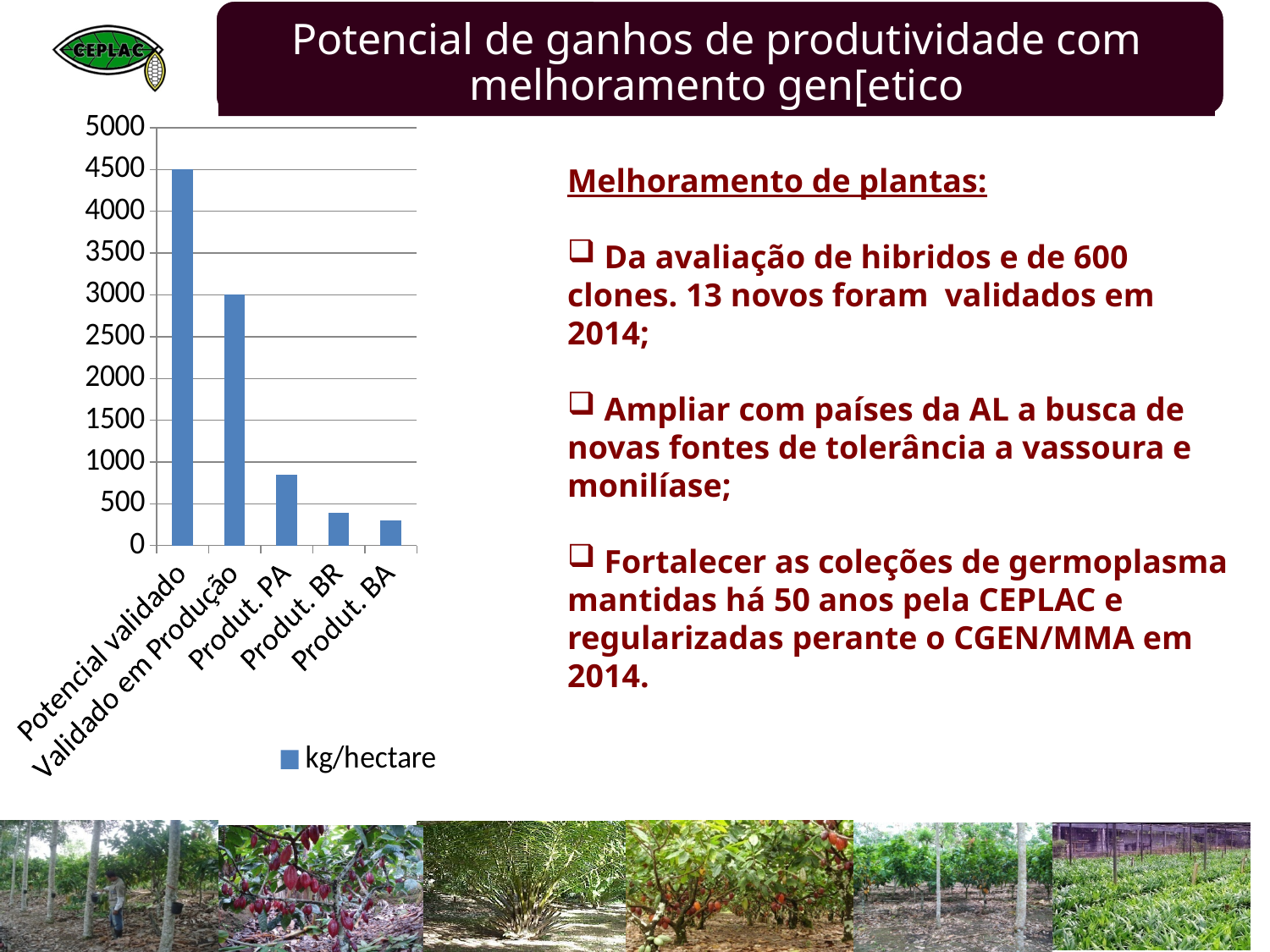
Which is larger, the value for Produt. PA or the value for Produt. BR? Produt. PA What is the value for Validado em Produção? 3000 What kind of chart is shown on the slide? bar chart Which category has the highest value? Potencial validado Is the value for Produt. BR greater or less than 500? less How many series does the chart legend list? 1 What series name is shown in the chart legend? kg/hectare What is the value for Potencial validado? 4500 Which category has the lowest value? Produt. BA What is the difference between the values for Potencial validado and Validado em Produção? 1500 How many categories are plotted on the x axis of the chart? 5 Is the value for Produt. PA greater or less than 1000? less